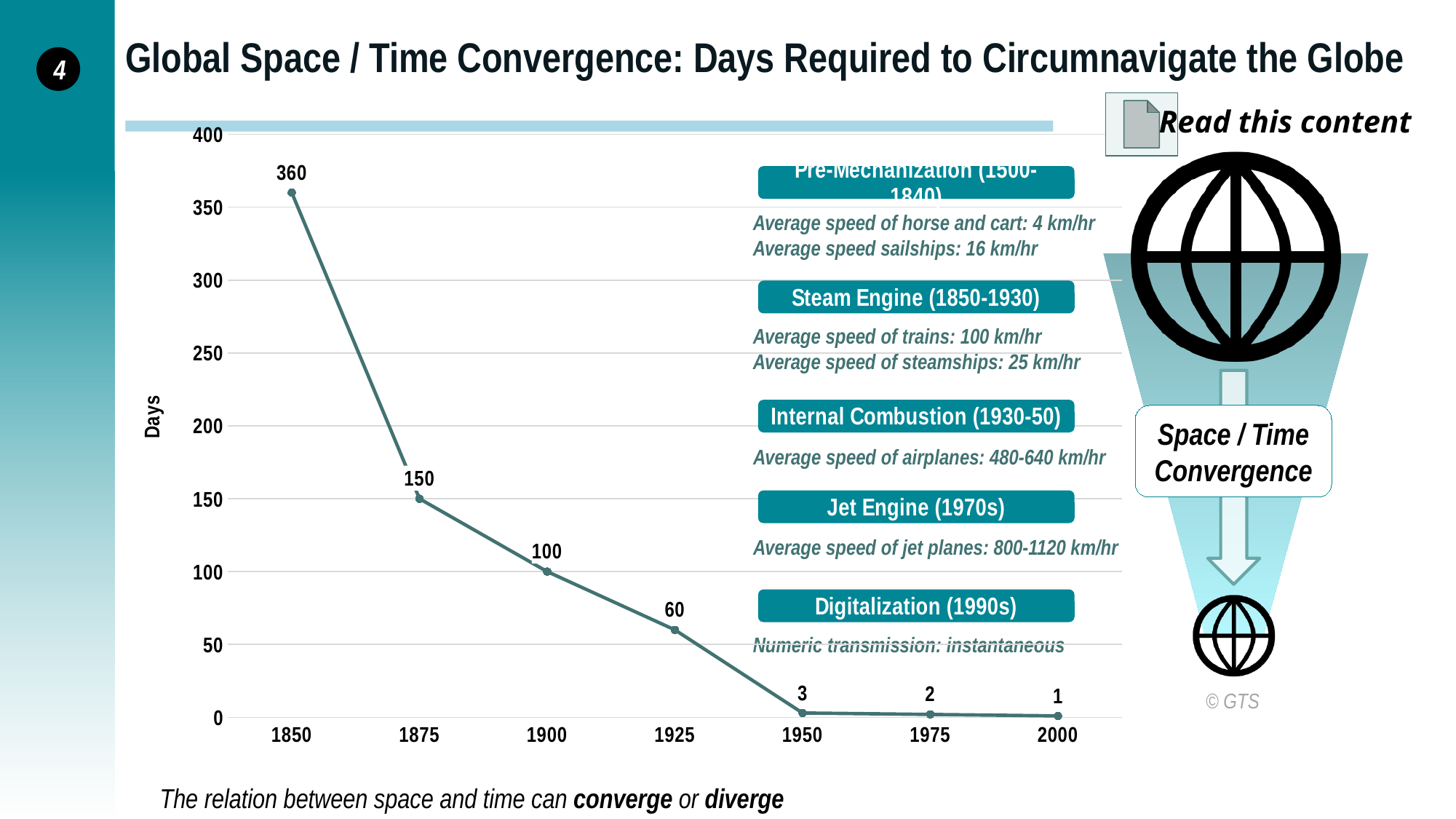
What kind of chart is shown on the slide? line chart What is the value plotted for 1925? 60 What is the difference between the values for 1950 and 1975? 1 Which year has the highest number of days? 1850 What is the value plotted for 1900? 100 Which is larger, the value for 1875 or the value for 1925? 1875 What is the value plotted for 2000? 1 Which year has the lowest number of days? 2000 How many data points are plotted on the line? 7 How many days were required to circumnavigate the globe in 1850? 360 Do the values rise or fall from 1850 to 2000? fall What is the difference between the values for 1850 and 1875? 210